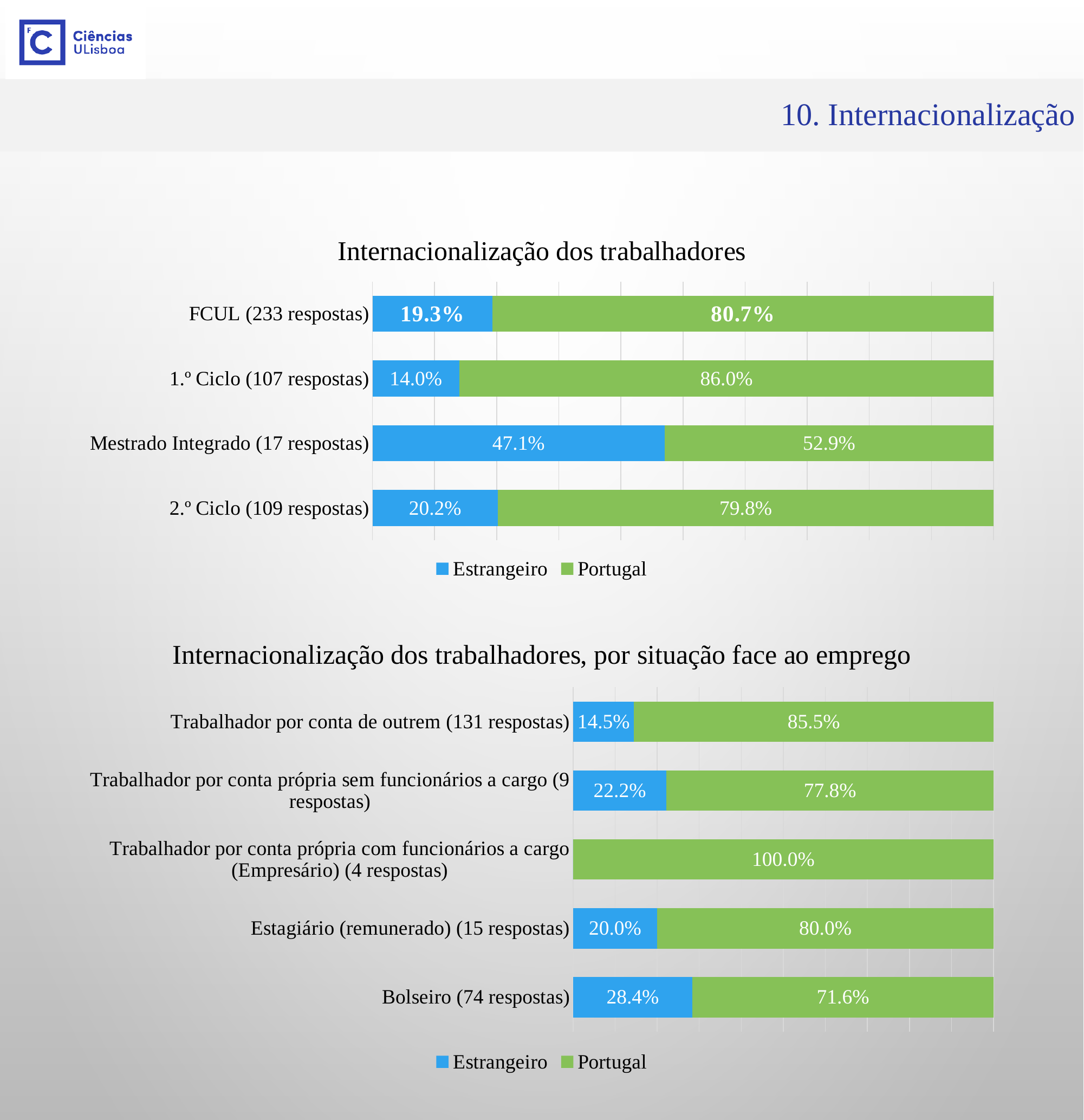
In the chart 'Internacionalização dos trabalhadores', how many categories are shown? 4 In the chart 'Internacionalização dos trabalhadores', what is the difference between the Portugal and Estrangeiro values for Mestrado Integrado (17 respostas)? 5.8% In the chart 'Internacionalização dos trabalhadores, por situação face ao emprego', what is the Estrangeiro value for Bolseiro (74 respostas)? 28.4% In the chart 'Internacionalização dos trabalhadores', what is the Estrangeiro value for FCUL (233 respostas)? 19.3% In the chart 'Internacionalização dos trabalhadores', which category has the highest Estrangeiro value? Mestrado Integrado (17 respostas) In the chart 'Internacionalização dos trabalhadores', what is the Portugal value for 1.º Ciclo (107 respostas)? 86.0% In the chart 'Internacionalização dos trabalhadores, por situação face ao emprego', what is the Portugal value for Trabalhador por conta própria com funcionários a cargo (Empresário) (4 respostas)? 100.0% In the chart 'Internacionalização dos trabalhadores', which category has the lowest Estrangeiro value? 1.º Ciclo (107 respostas) How many series does the legend of the chart 'Internacionalização dos trabalhadores' list? 2 In the chart 'Internacionalização dos trabalhadores, por situação face ao emprego', is the Estrangeiro value larger for Estagiário (remunerado) (15 respostas) or for Trabalhador por conta de outrem (131 respostas)? Estagiário (remunerado) (15 respostas) In the chart 'Internacionalização dos trabalhadores, por situação face ao emprego', which category has the highest Estrangeiro value? Bolseiro (74 respostas) In the chart 'Internacionalização dos trabalhadores, por situação face ao emprego', how many categories are shown? 5